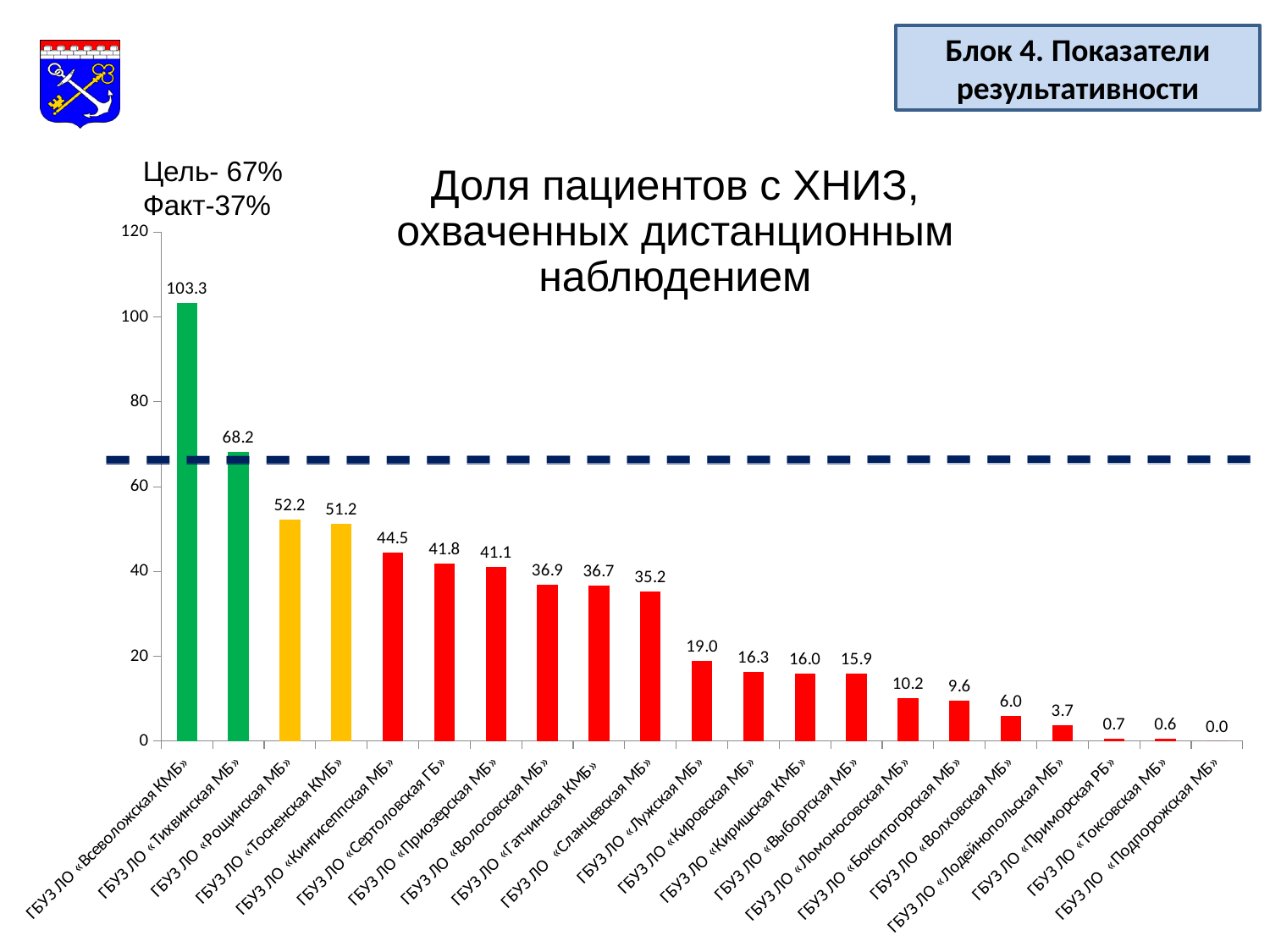
Which is larger, the value for ГБУЗ ЛО «Кингисеппская МБ» or ГБУЗ ЛО «Сланцевская МБ»? ГБУЗ ЛО «Кингисеппская МБ» What is the value for ГБУЗ ЛО «Всеволожская КМБ»? 103.3 What is the value for ГБУЗ ЛО «Бокситогорская МБ»? 9.6 Which category has the lowest value? ГБУЗ ЛО «Подпорожская МБ» Which category has the highest value? ГБУЗ ЛО «Всеволожская КМБ» How many categories are shown in the chart? 21 What is the difference between the values for ГБУЗ ЛО «Тихвинская МБ» and ГБУЗ ЛО «Рощинская МБ»? 16.0 What kind of chart is shown on the slide? bar chart Is the value for ГБУЗ ЛО «Тосненская КМБ» greater or less than 60? less Do the values rise or fall from left to right along the x axis? fall What is the title of the chart? Доля пациентов с ХНИЗ, охваченных дистанционным наблюдением What is the value for ГБУЗ ЛО «Лужская МБ»? 19.0